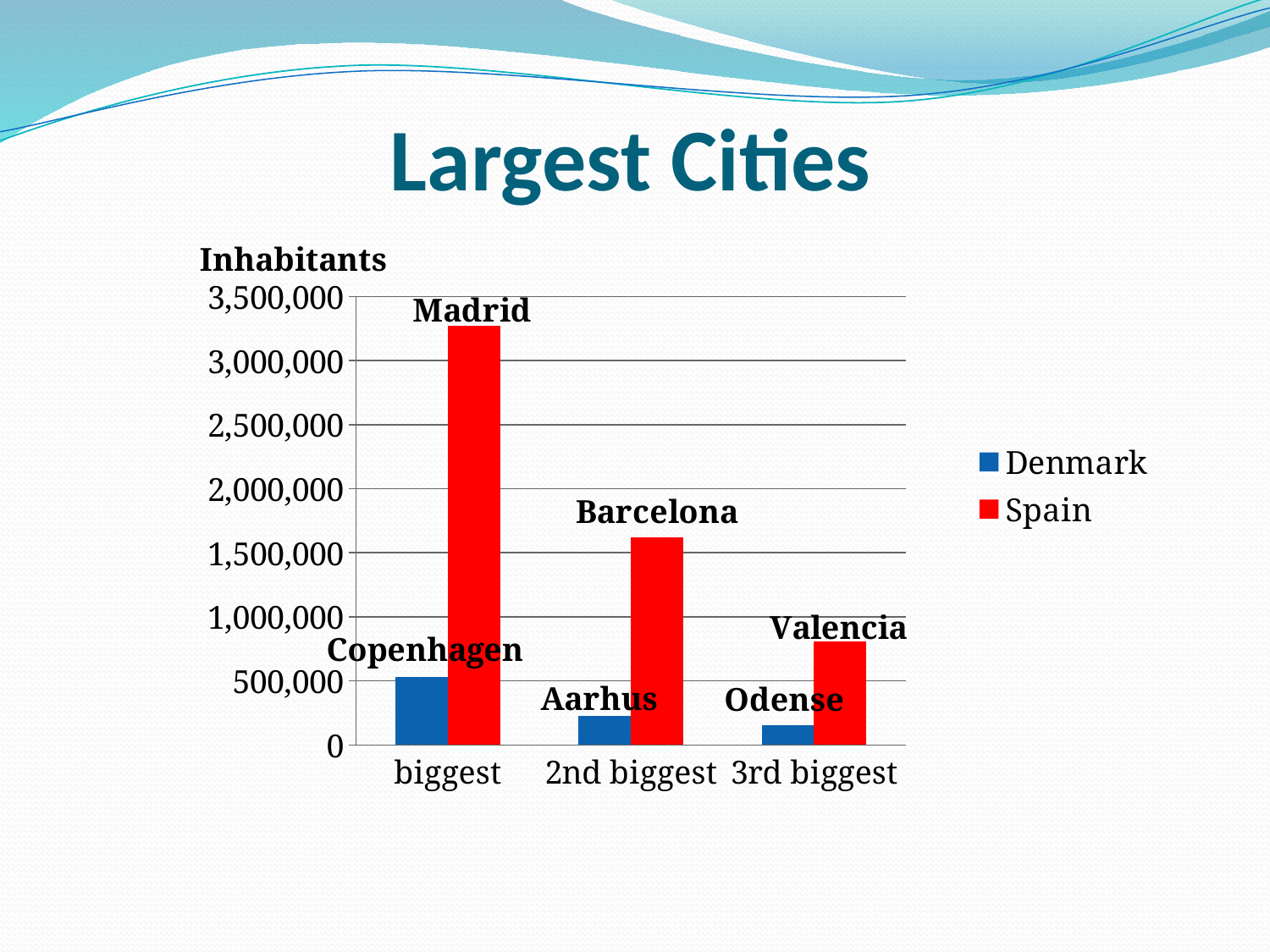
Is the value for Aarhus greater or less than 500,000? less Which bar is the tallest in the chart? Spain, biggest (Madrid) How many categories are shown on the x axis? 3 What kind of chart is shown on the slide? bar chart Is the value for Barcelona greater or less than 1,500,000? greater In the 'biggest' category, which is larger: the Denmark bar or the Spain bar? Spain Which bar is the shortest in the chart? Denmark, 3rd biggest (Odense) Is the value for Valencia greater or less than 1,000,000? less What is the title of the chart on the slide? Largest Cities How many series does the legend list? 2 Do the Spain values rise or fall from 'biggest' to '3rd biggest'? fall